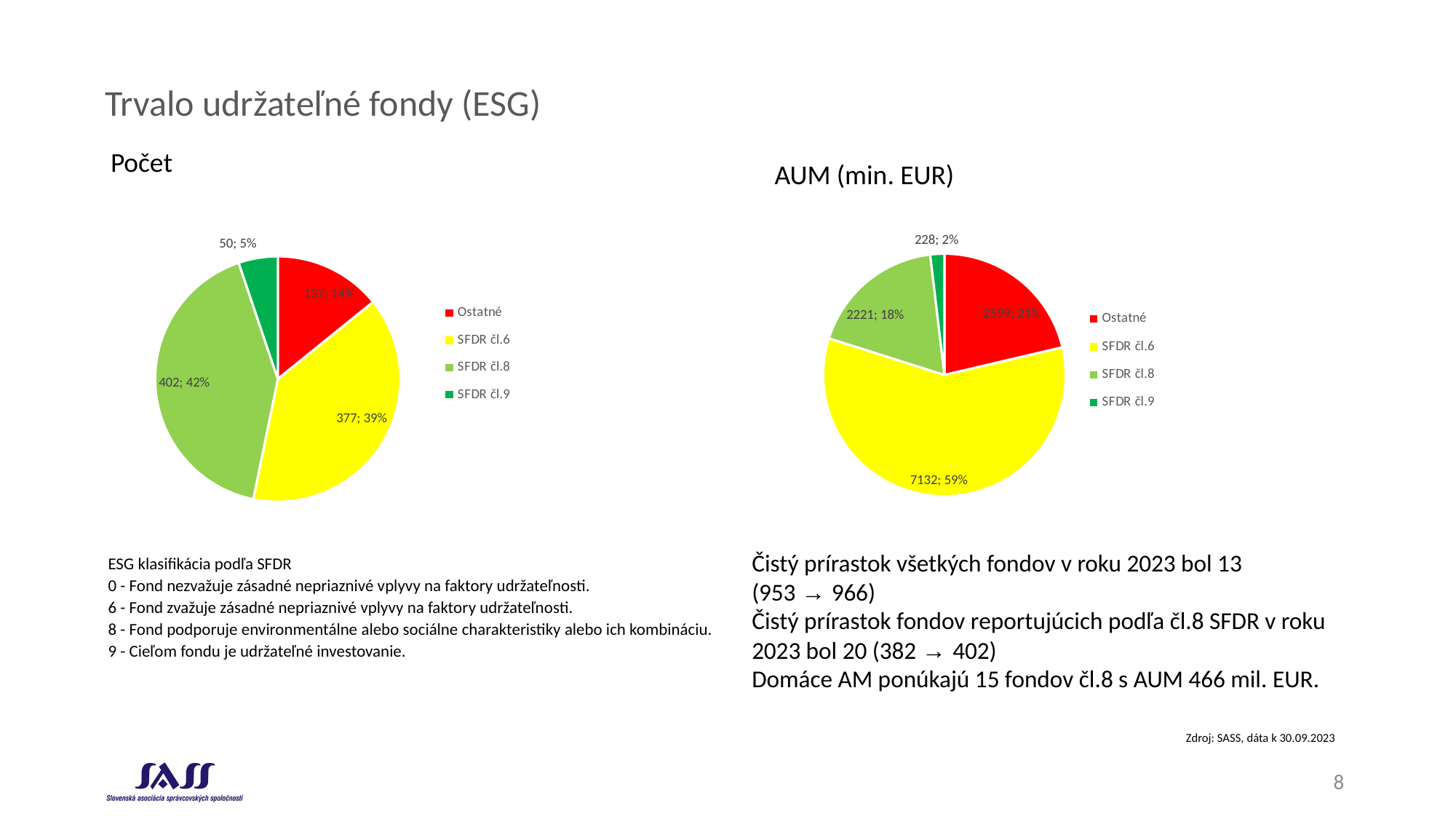
In the "AUM (min. EUR)" chart, which category has the largest slice? SFDR čl.6 In the "Počet" chart, what is the difference between the values for SFDR čl.8 and SFDR čl.6? 25 In the "Počet" chart, which is larger: Ostatné or SFDR čl.9? Ostatné In the "Počet" chart, what is the value for SFDR čl.8? 402 How many categories does the "AUM (min. EUR)" chart show? 4 In the "Počet" chart, which category has the smallest slice? SFDR čl.9 In the "Počet" chart, what share of the pie does SFDR čl.6 represent? 39% What type of chart is the "Počet" chart? Pie chart In the "Počet" chart, which colour represents SFDR čl.9 in the legend? Green In the "AUM (min. EUR)" chart, what share of the pie does Ostatné represent? 21% In the "AUM (min. EUR)" chart, what is the value for SFDR čl.6? 7132 In the "AUM (min. EUR)" chart, what is the difference between the values for Ostatné and SFDR čl.8? 378